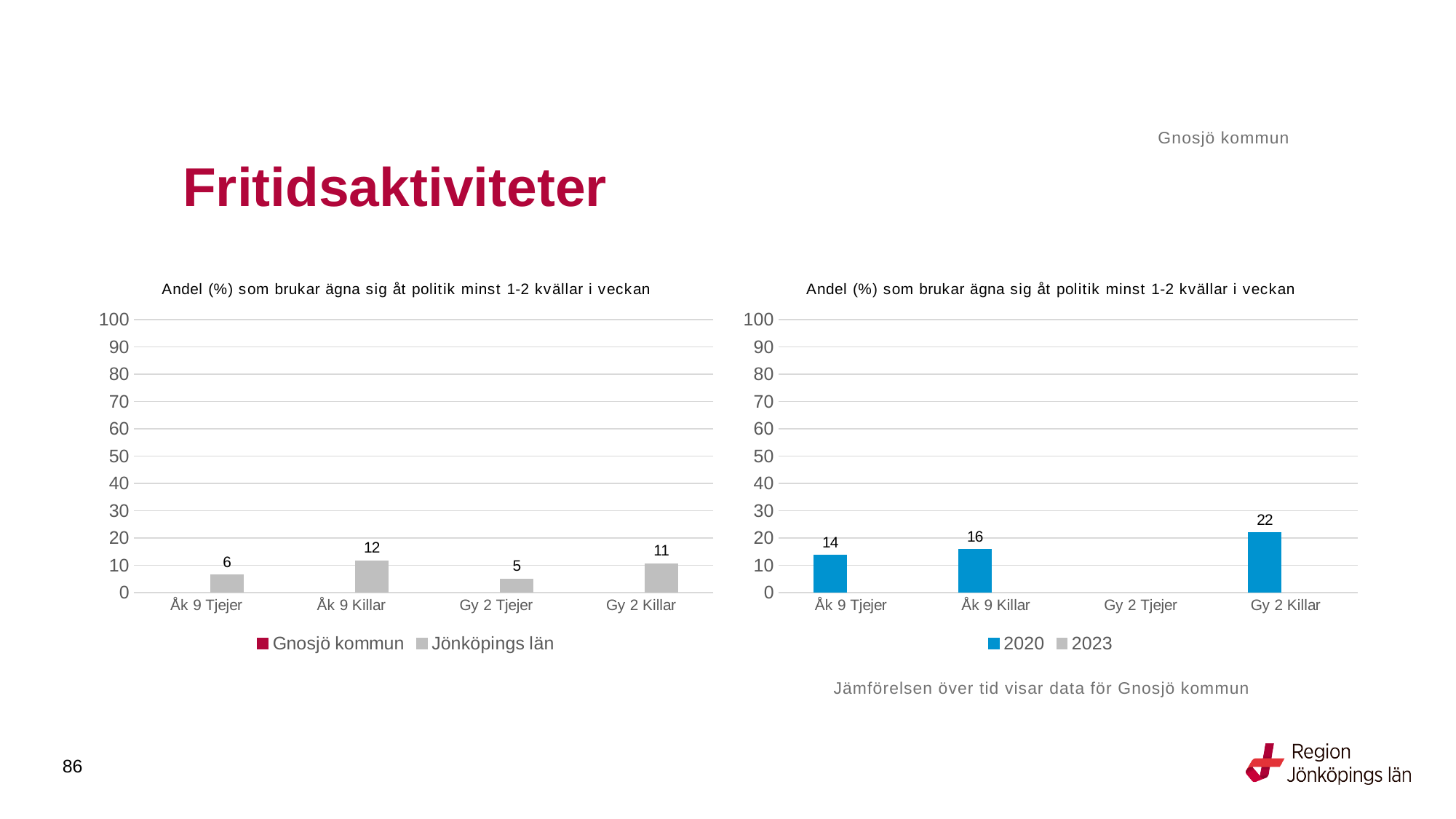
In the right chart, which category has the highest 2020 value? Gy 2 Killar In the right chart, what is the difference between the 2020 values for Gy 2 Killar and Åk 9 Killar? 6 In the right chart, what is the 2020 value for Gy 2 Killar? 22 In the left chart, what is the value for Jönköpings län for Gy 2 Tjejer? 5 In the left chart, which category has the lowest value for Jönköpings län? Gy 2 Tjejer In the left chart, which category has the highest value for Jönköpings län? Åk 9 Killar In the right chart, what is the 2020 value for Åk 9 Tjejer? 14 In the left chart, what is the difference between the Jönköpings län values for Åk 9 Killar and Åk 9 Tjejer? 6 In the right chart, is the 2020 value for Åk 9 Killar greater or less than 20? less In the left chart, what is the value for Jönköpings län for Åk 9 Killar? 12 What kind of chart is the right chart? bar chart In the left chart, how many series does the legend list? 2